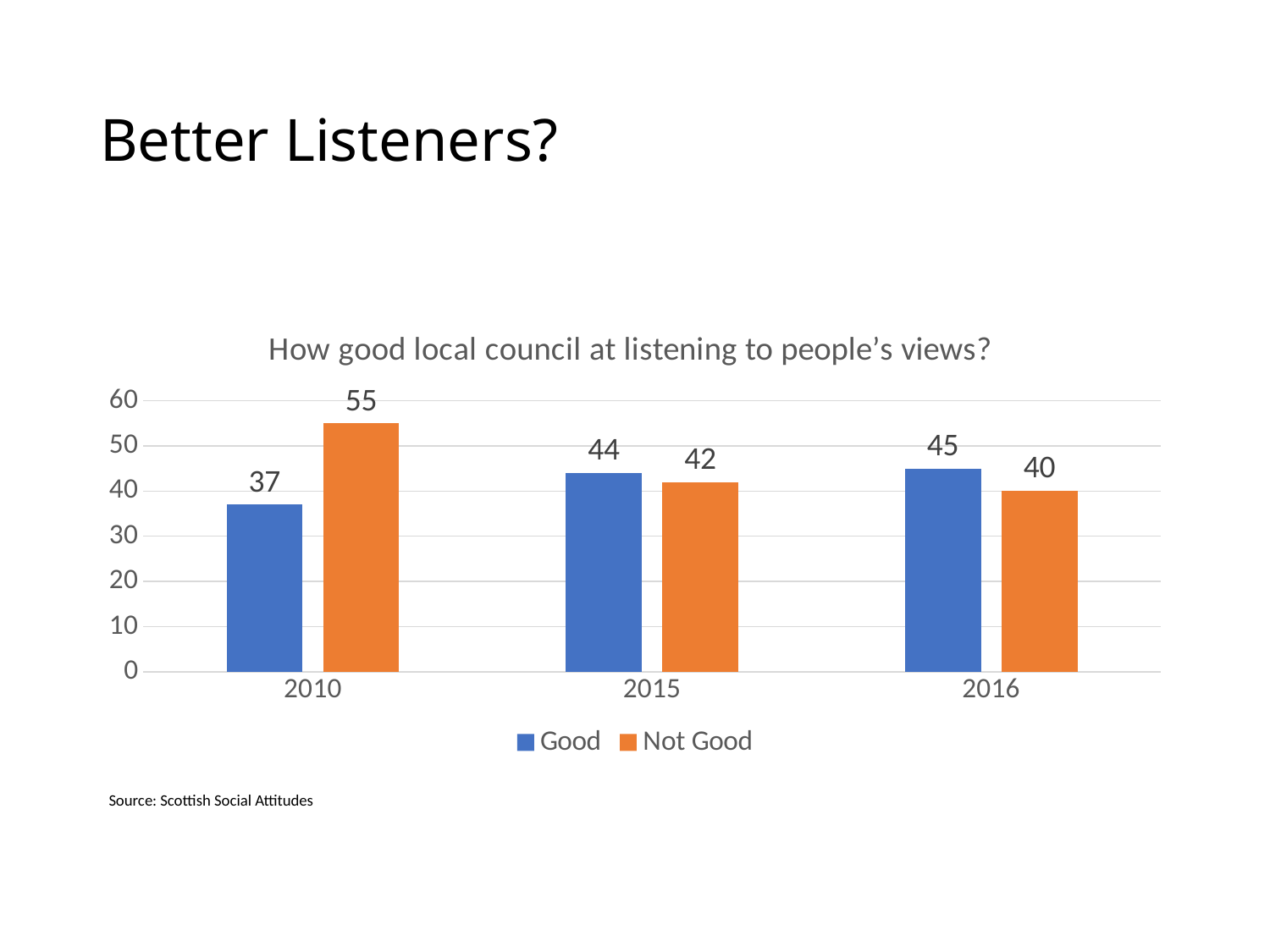
Does the Not Good value rise or fall from 2010 to 2016? fall How many years are shown on the x axis? 3 Is the value for Not Good in 2010 greater or less than 50? greater What is the difference between Not Good and Good in 2010? 18 What kind of chart is shown? bar chart What is the value for Not Good in 2016? 40 In which year is the Not Good value highest? 2010 How many series does the legend list? 2 In which year is the Good value lowest? 2010 Which is larger in 2016, Good or Not Good? Good What is the value for Not Good in 2015? 42 What is the value for Good in 2010? 37